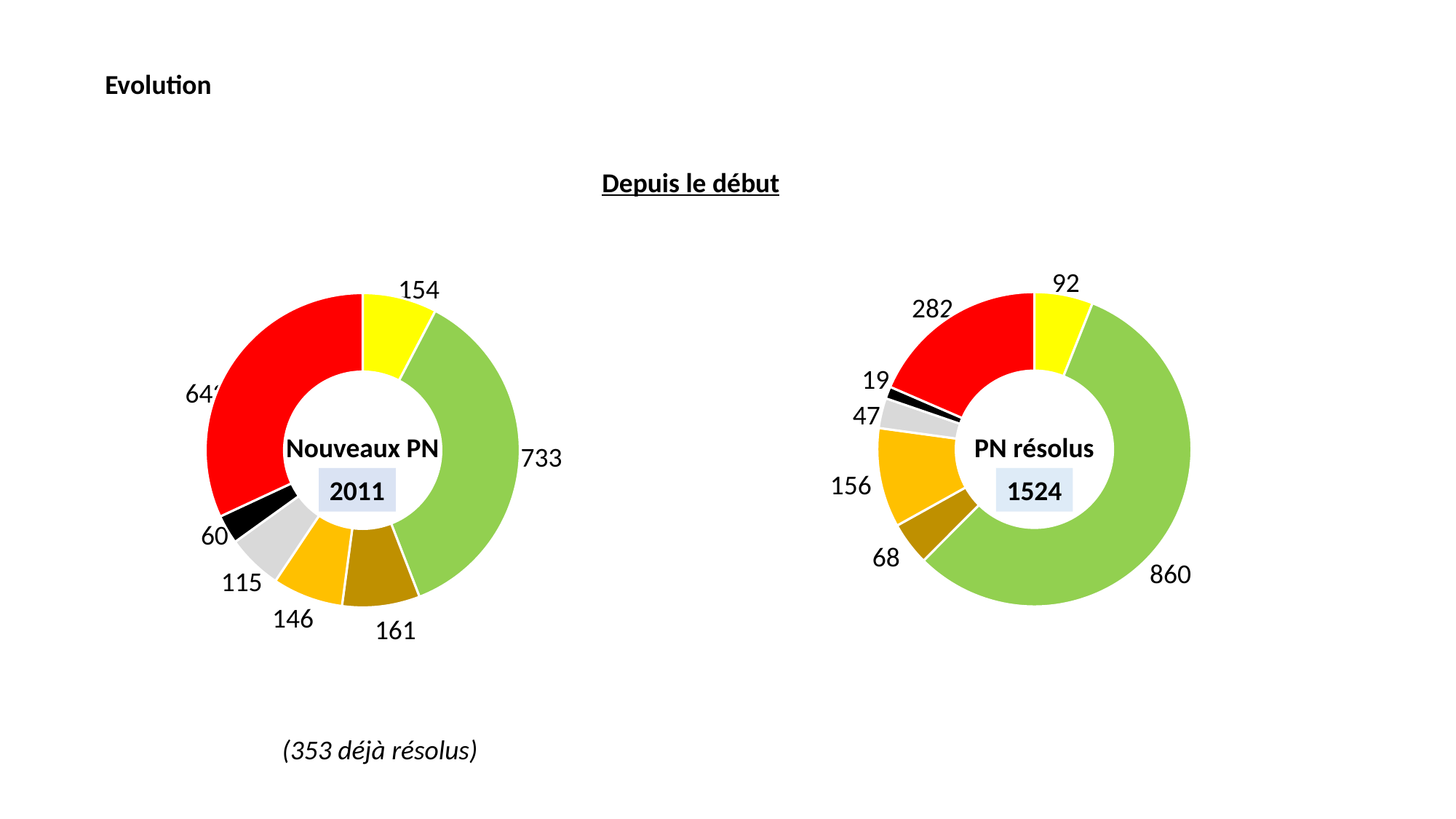
What total is shown in the centre of the "Nouveaux PN" chart? 2011 What total is shown in the centre of the "PN résolus" chart? 1524 In the "PN résolus" chart, which slice has the smallest value? The black slice (19) In the "PN résolus" chart, which slice has the largest value? The green slice (860) In the "Nouveaux PN" chart, what is the difference between the green slice (733) and the yellow slice (154)? 579 In the "PN résolus" chart, what value is shown for the black slice? 19 What type of chart is used for "Nouveaux PN"? Doughnut (pie) chart In the "PN résolus" chart, what value is shown for the red slice? 282 How many slices does the "PN résolus" chart have? 7 In the "Nouveaux PN" chart, what value is shown for the yellow slice? 154 In the "PN résolus" chart, which is larger: the orange slice or the grey slice? The orange slice (156) In the "Nouveaux PN" chart, what value is shown for the green slice? 733